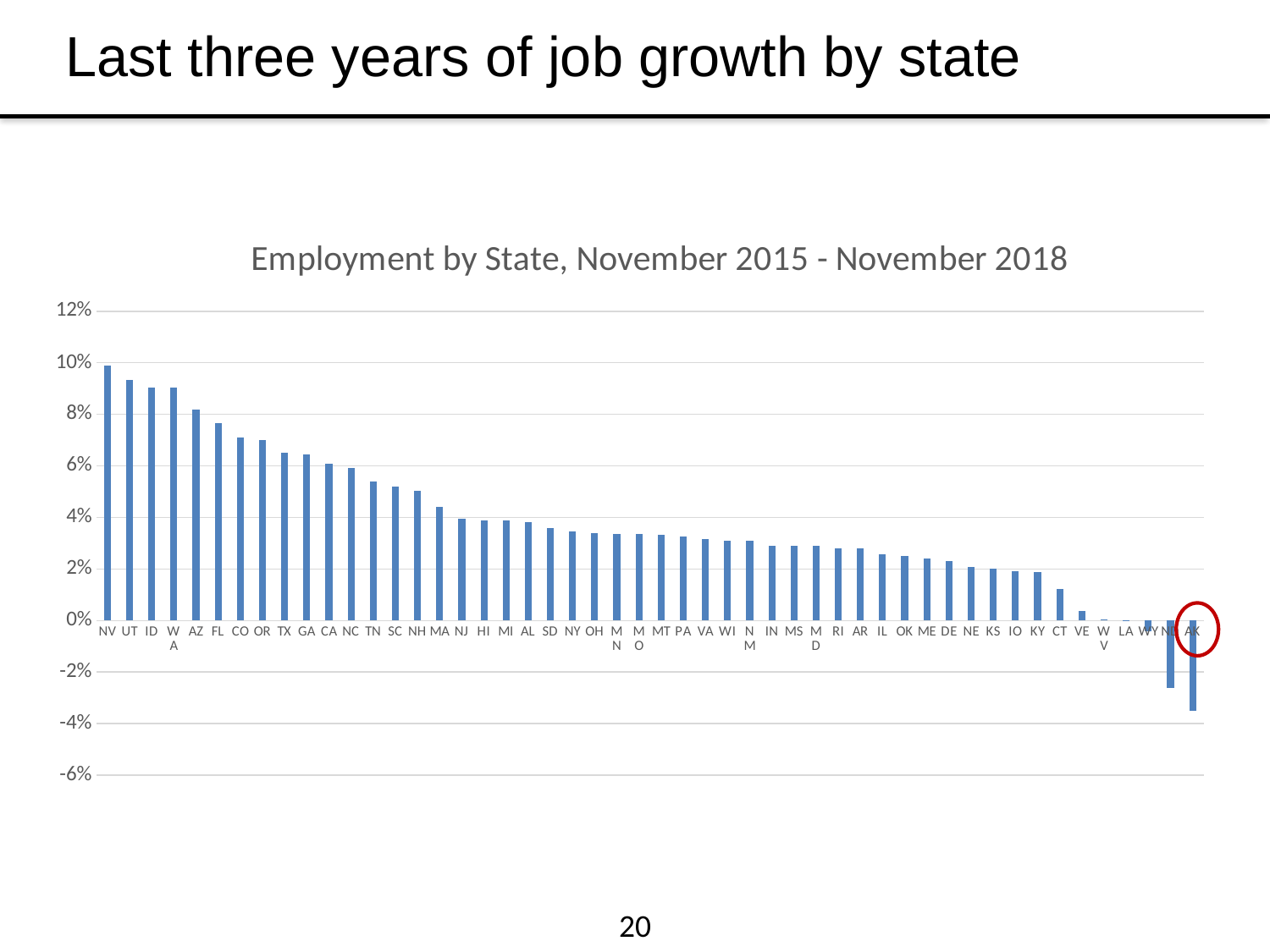
What is the title of the chart? Employment by State, November 2015 - November 2018 Which has the larger value, CO or NJ? CO Is the value for CT greater or less than 2%? less Do the values rise or fall moving from left to right along the x axis? fall Is the value for FL greater or less than 6%? greater Is the value for NV greater or less than 8%? greater Which state has the lowest employment growth in the chart? AK Which state has the highest employment growth in the chart? NV What kind of chart is shown on the slide? bar chart Which has the larger value, NV or AZ? NV